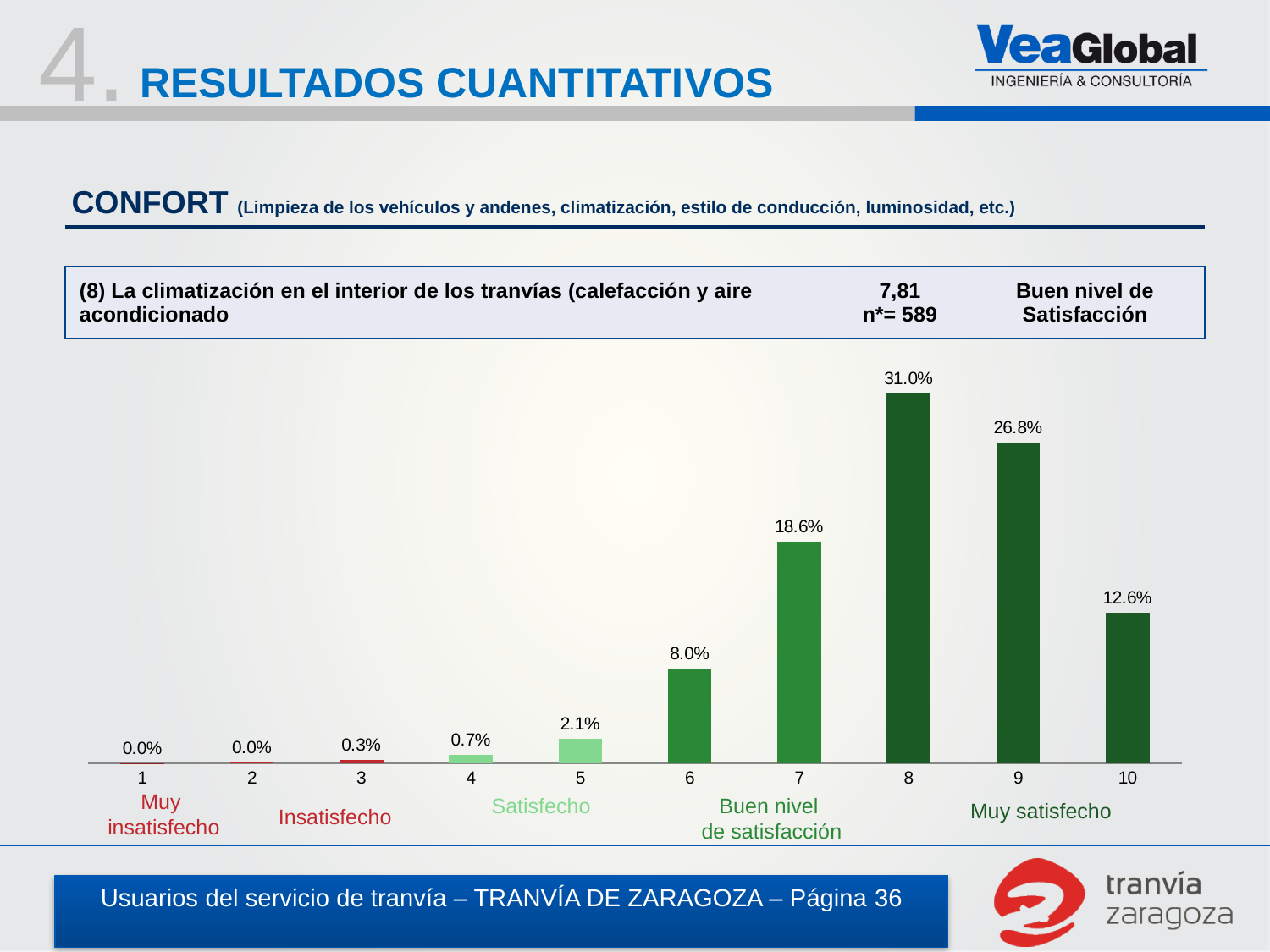
Which category has the highest value? 8 What is the value for category 5? 2.1% What is the difference between the values for categories 7 and 6? 10.6% How many categories are shown on the x axis? 10 What is the sample size (n*) shown above the chart? 589 What is the value for category 6? 8.0% What is the value for category 10? 12.6% What kind of chart is shown? bar chart What is the value for category 8? 31.0% Which is larger, the value for category 9 or the value for category 10? 9 Do the values rise or fall from category 1 to category 8? rise What is the difference between the values for categories 8 and 9? 4.2%